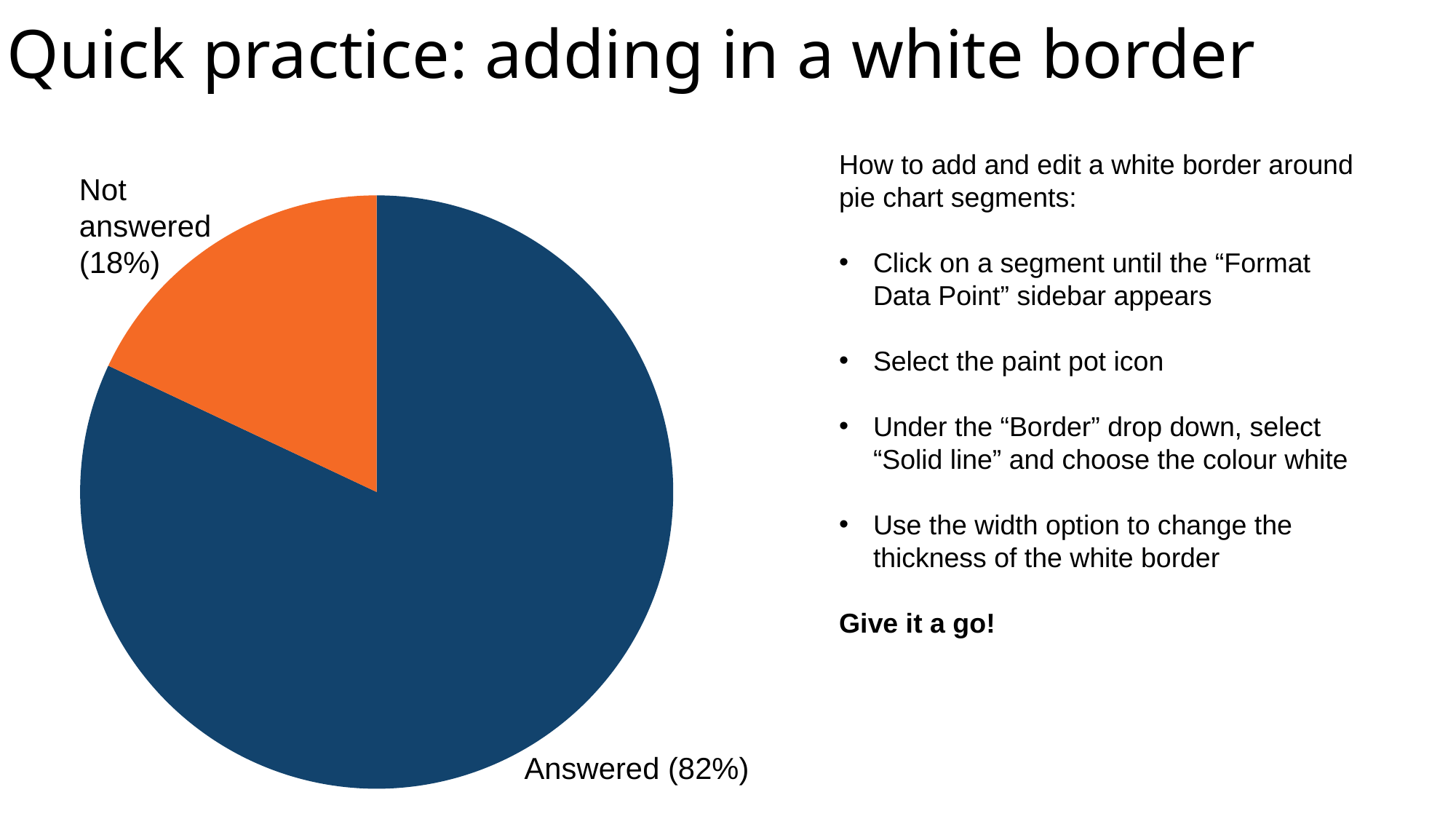
Which is larger, the Answered slice or the Not answered slice? Answered What colour is the Not answered slice? orange What is the difference in percentage points between the Answered and Not answered slices? 64 Which slice of the pie is the smallest? Not answered What share of the pie is labelled "Not answered"? 18% Which slice of the pie is the largest? Answered What kind of chart is shown on the slide? pie chart How many slices does the pie chart have? 2 What colour is the Answered slice? dark blue What share of the pie is labelled "Answered"? 82% Is the share for Not answered greater or less than 25%? less